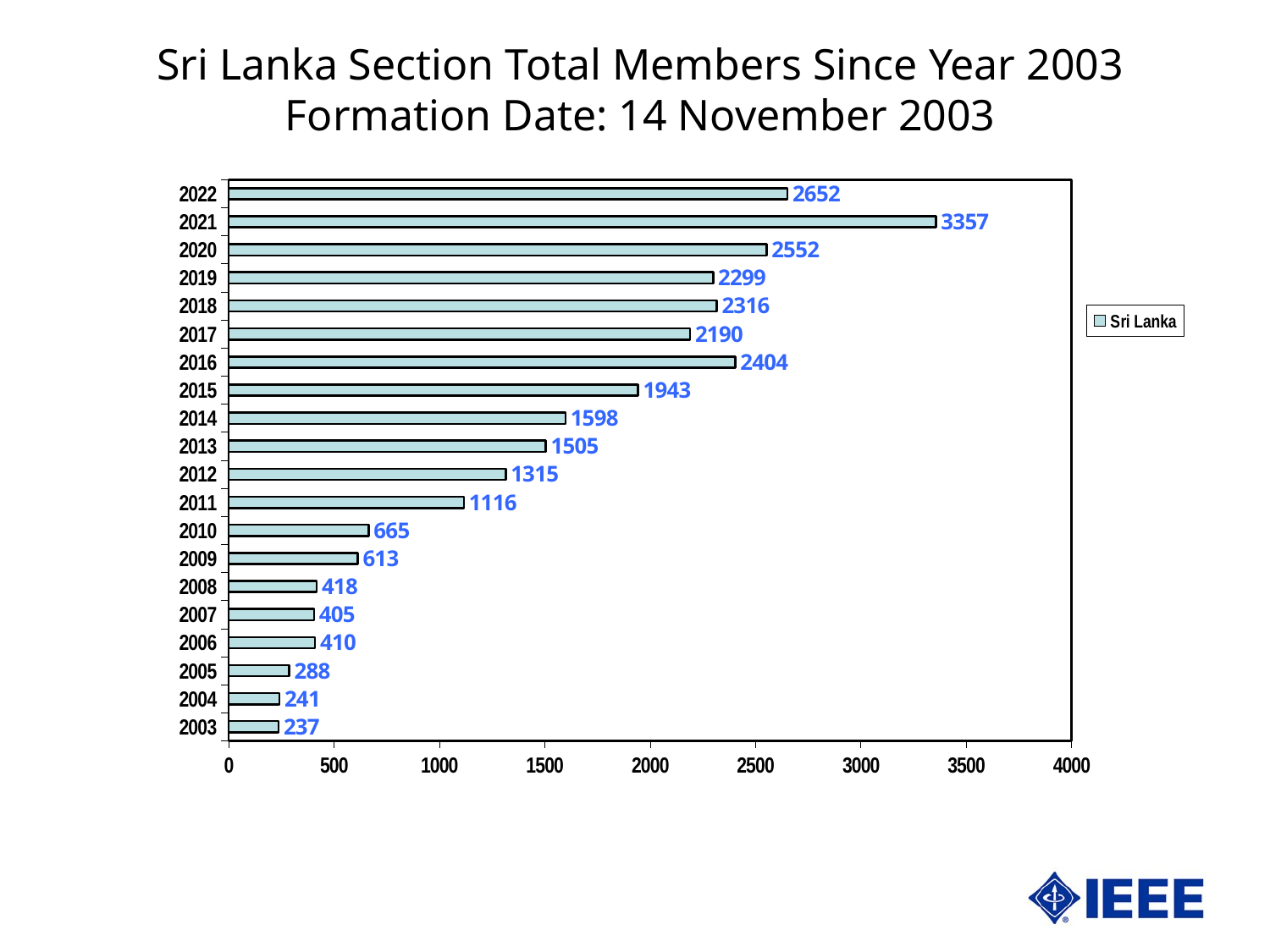
How many years are shown in the chart? 20 Which year had more members, 2016 or 2017? 2016 What was the total number of Sri Lanka Section members in 2003? 237 What was the total number of Sri Lanka Section members in 2021? 3357 What type of chart is shown on the slide? Bar chart Which year had the lowest number of members? 2003 How many more members were there in 2021 than in 2022? 705 What is the difference in members between 2011 and 2010? 451 What is the name of the series listed in the legend? Sri Lanka What was the total number of Sri Lanka Section members in 2015? 1943 Which year had more members, 2006 or 2007? 2006 Which year had the highest number of members? 2021